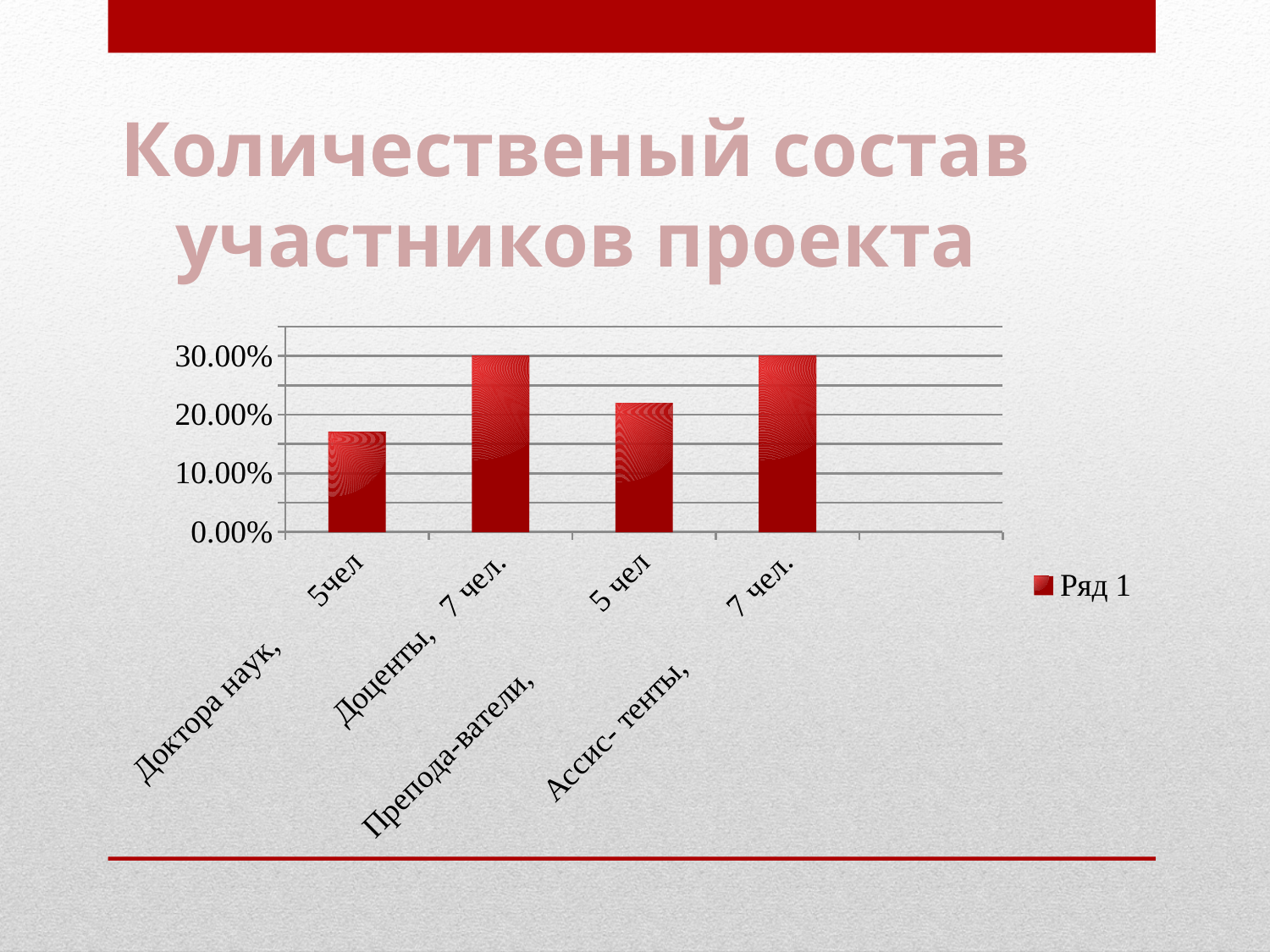
Which is larger, the value for "Доценты, 7 чел." or the value for "Препода-ватели, 5 чел"? Доценты, 7 чел. Is the value for "Доктора наук, 5чел" greater or less than 20.00%? less What is the value for "Доценты, 7 чел."? 30.00% Which category has the lowest value? Доктора наук, 5чел Which is larger, the value for "Препода-ватели, 5 чел" or the value for "Доктора наук, 5чел"? Препода-ватели, 5 чел How many series does the legend list? 1 What kind of chart is shown on the slide? bar chart Is the value for "Препода-ватели, 5 чел" greater or less than 20.00%? greater What is the title of the slide containing the chart? Количественый состав участников проекта How many categories are plotted on the chart? 4 What is the name of the series shown in the legend? Ряд 1 What is the value for "Ассис- тенты, 7 чел."? 30.00%